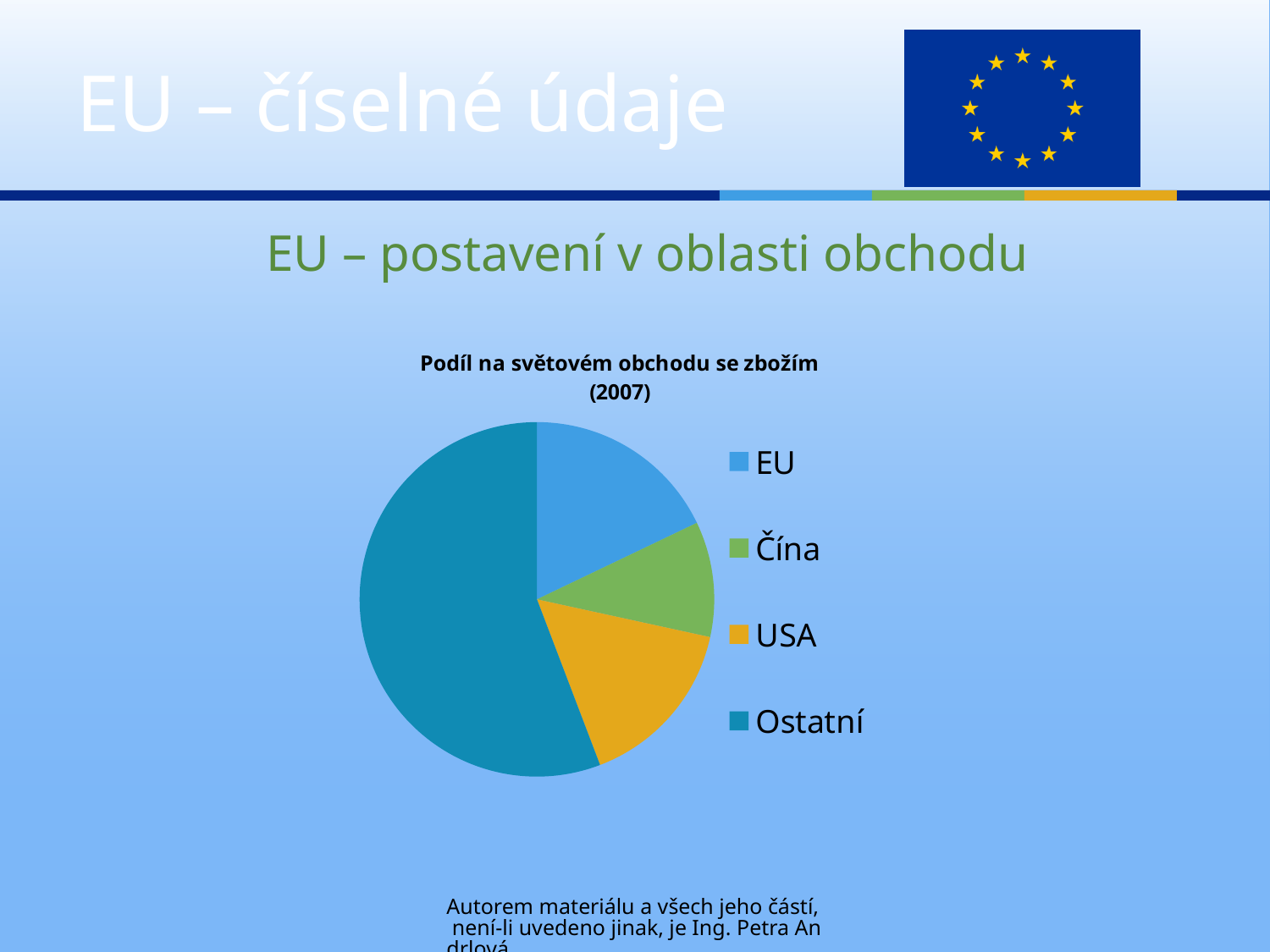
Which category has the largest slice in the pie chart? Ostatní Which year does the pie chart's title refer to? 2007 What kind of chart is shown on the slide? pie chart Does the Ostatní slice take up more or less than half of the pie chart? more What is the title of the pie chart? Podíl na světovém obchodu se zbožím (2007) Which category has the smallest slice in the pie chart? Čína Which slice is larger in the pie chart, EU or Čína? EU How many slices does the pie chart have? 4 Which slice is larger in the pie chart, USA or Čína? USA Which slice is larger in the pie chart, Ostatní or EU? Ostatní How many entries does the legend of the pie chart list? 4